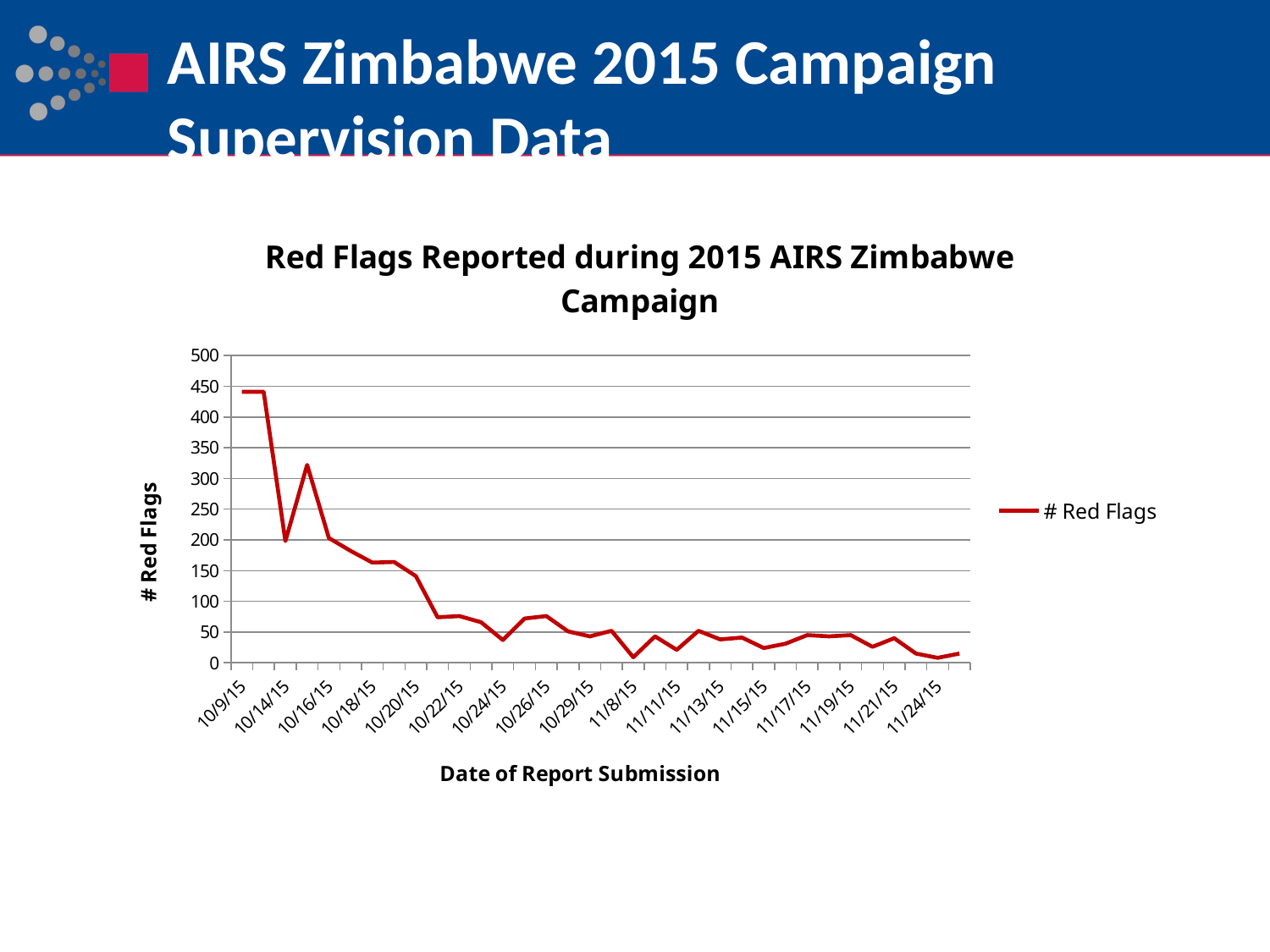
Which has the larger number of red flags, 10/9/15 or 11/24/15? 10/9/15 What is the title of the chart? Red Flags Reported during 2015 AIRS Zimbabwe Campaign Is the value for 10/9/15 greater or less than 400? greater Do the number of red flags generally rise or fall over the dates shown? fall How many series does the legend list? 1 Is the value for 11/24/15 greater or less than 50? less What is the name of the series shown in the legend? # Red Flags Is the value for 11/24/15 greater or less than 100? less What kind of chart is shown on the slide? line chart What is the highest value shown on the y axis? 500